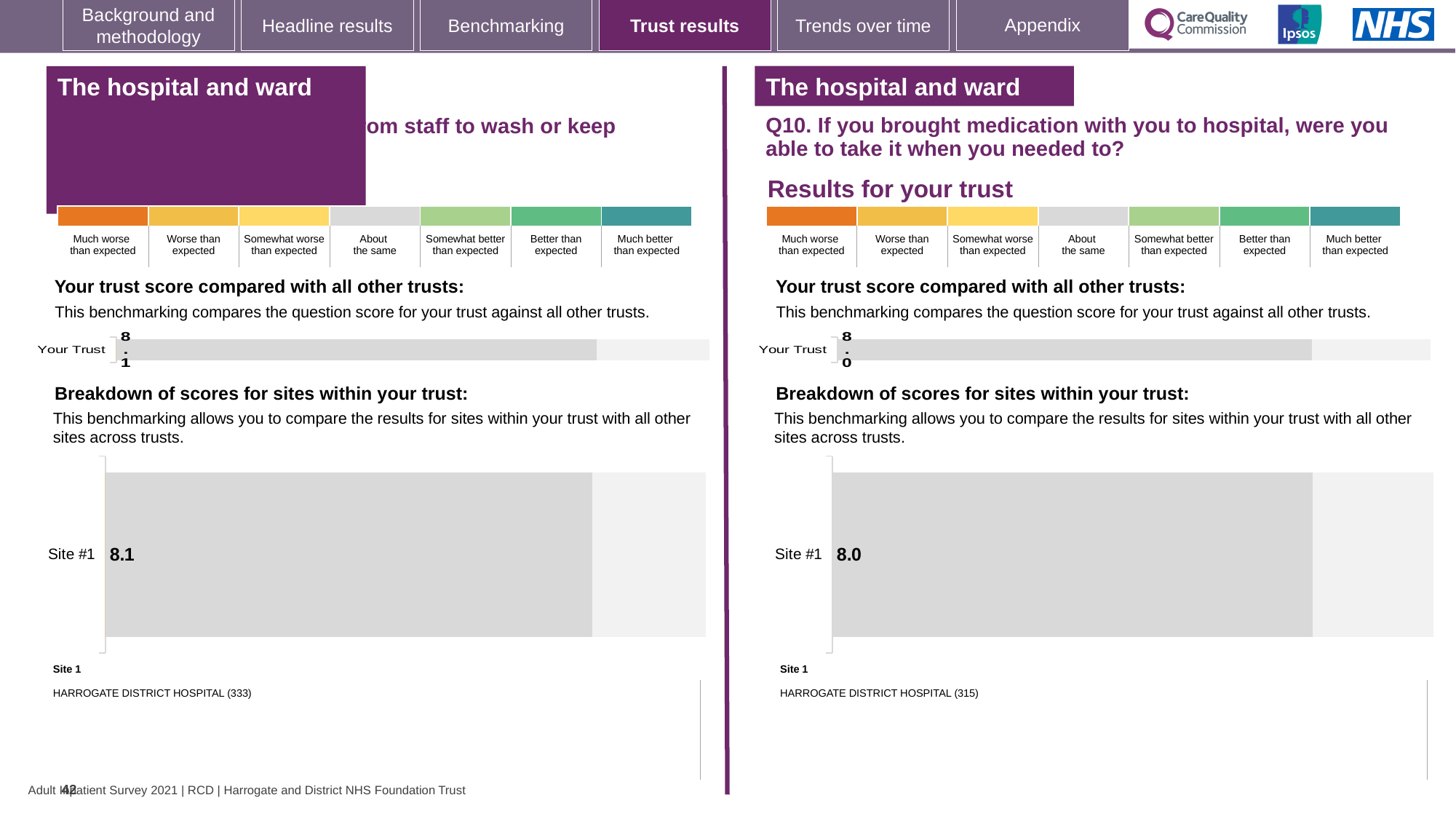
How many sites are plotted in the 'Breakdown of scores for sites within your trust' chart on the right-hand side of the slide (Q10)? 1 Which is larger: the Site #1 score on the left-hand side of the slide or the Site #1 score on the right-hand side (Q10)? Left-hand side (8.1) What is the category label of the single bar in the trust score chart on the right-hand side of the slide (Q10)? Your Trust What is the difference between the Site #1 score on the left-hand side of the slide and the Site #1 score on the right-hand side (Q10)? 0.1 How many sites are plotted in the 'Breakdown of scores for sites within your trust' chart on the left-hand side of the slide? 1 Which hospital is listed as Site 1 beneath the breakdown chart on the right-hand side of the slide (Q10)? HARROGATE DISTRICT HOSPITAL (315) On the left-hand side of the slide, what is the score shown for Site #1 in the breakdown of scores for sites chart? 8.1 What type of chart is used for the 'Breakdown of scores for sites within your trust' on the right-hand side of the slide? Bar chart On the right-hand side of the slide (Q10), what score is shown for 'Your Trust' in the trust score chart? 8.0 On the right-hand side of the slide (Q10, medication), what is the score shown for Site #1 in the breakdown of scores for sites chart? 8.0 On the left-hand side of the slide, what score is shown for 'Your Trust' in the trust score chart? 8.1